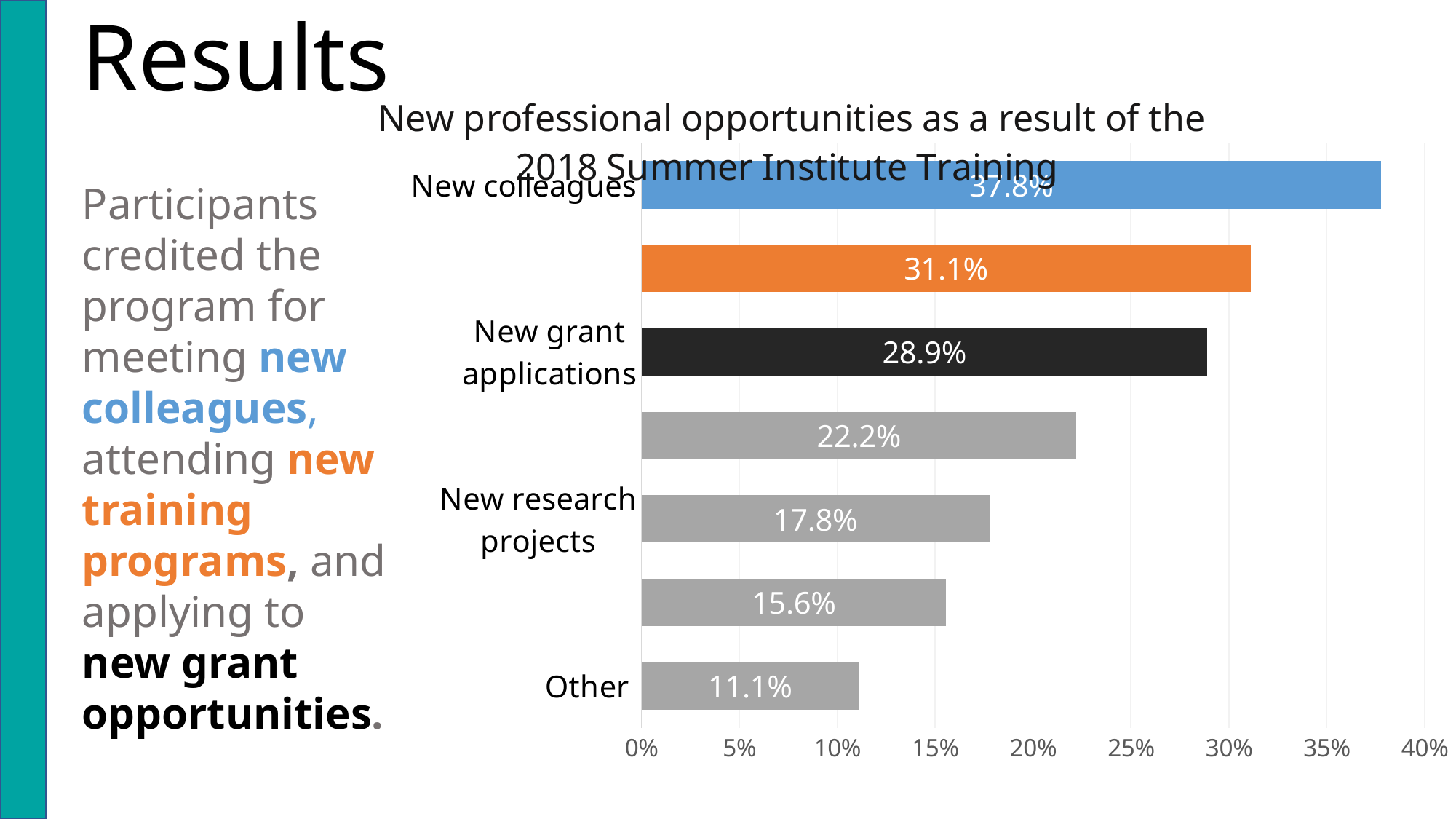
What is the value for New grant applications? 28.9% What is the value for New research projects? 17.8% What is the value for New colleagues? 37.8% What is the difference between the values for New colleagues and New grant applications? 8.9% Is the value for New colleagues greater or less than 35%? greater Which category has the lowest value? Other What is the value for Other? 11.1% What is the difference between the values for New research projects and Other? 6.7% Which is larger, the value for New grant applications or the value for New research projects? New grant applications Which category has the highest value? New colleagues What kind of chart is shown on the slide? bar chart How many bars are plotted in the chart? 7